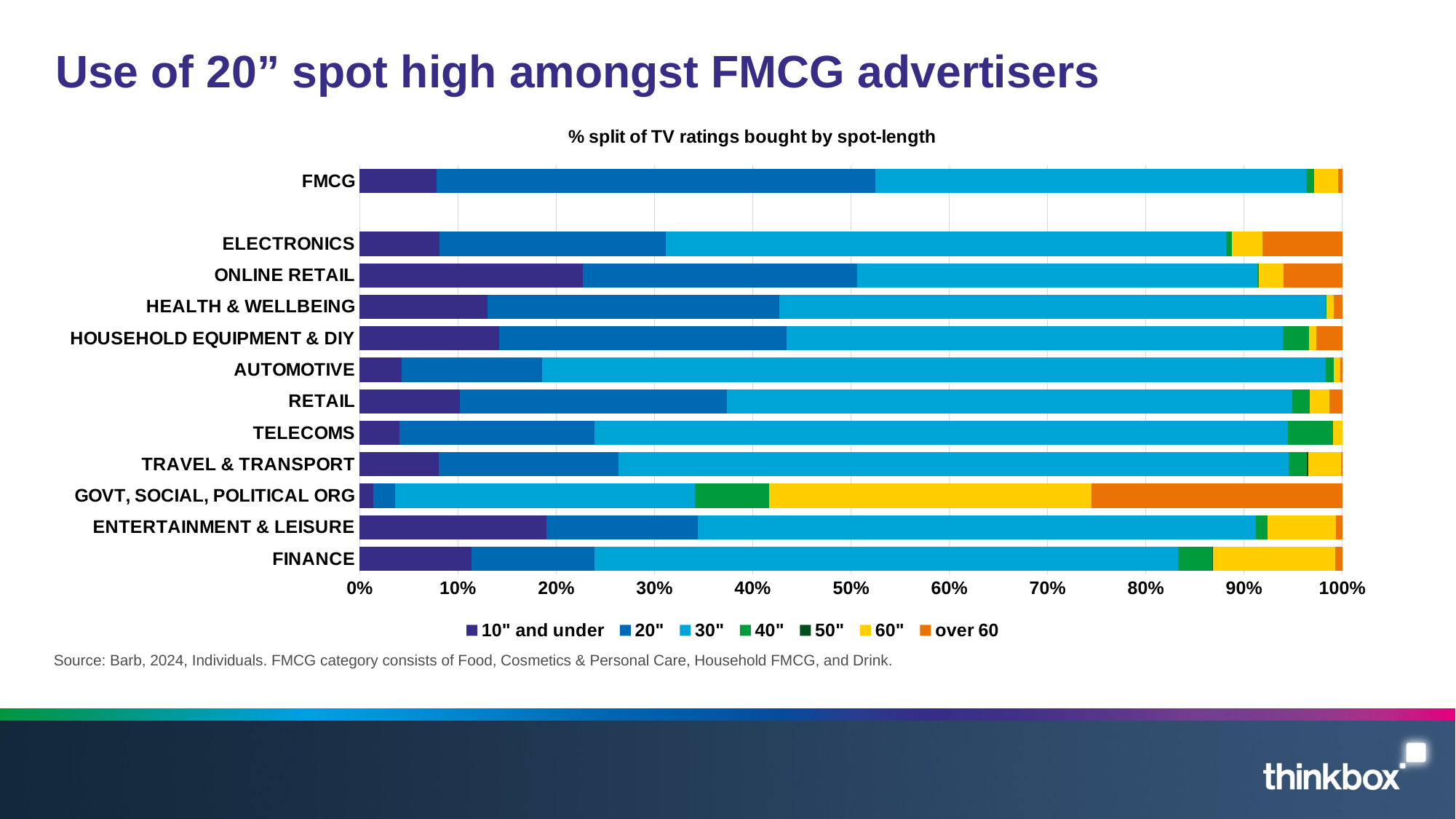
How many series does the legend list? 7 What type of chart is shown on the slide? Stacked bar chart Which category has the largest share for the '20"' spot length? FMCG Which category has the smallest share for the '10" and under' spot length? GOVT, SOCIAL, POLITICAL ORG What is the title of the chart? % split of TV ratings bought by spot-length Which category has the largest share for the 'over 60' spot length? GOVT, SOCIAL, POLITICAL ORG Which has a larger '20"' share, FMCG or FINANCE? FMCG Which has a larger '10" and under' share, FMCG or ONLINE RETAIL? ONLINE RETAIL How many advertiser categories are plotted in the chart? 12 Which category has the largest share for the '10" and under' spot length? ONLINE RETAIL Is the '10" and under' share for AUTOMOTIVE greater or less than 10%? less Is the '10" and under' share for ONLINE RETAIL greater or less than 20%? greater